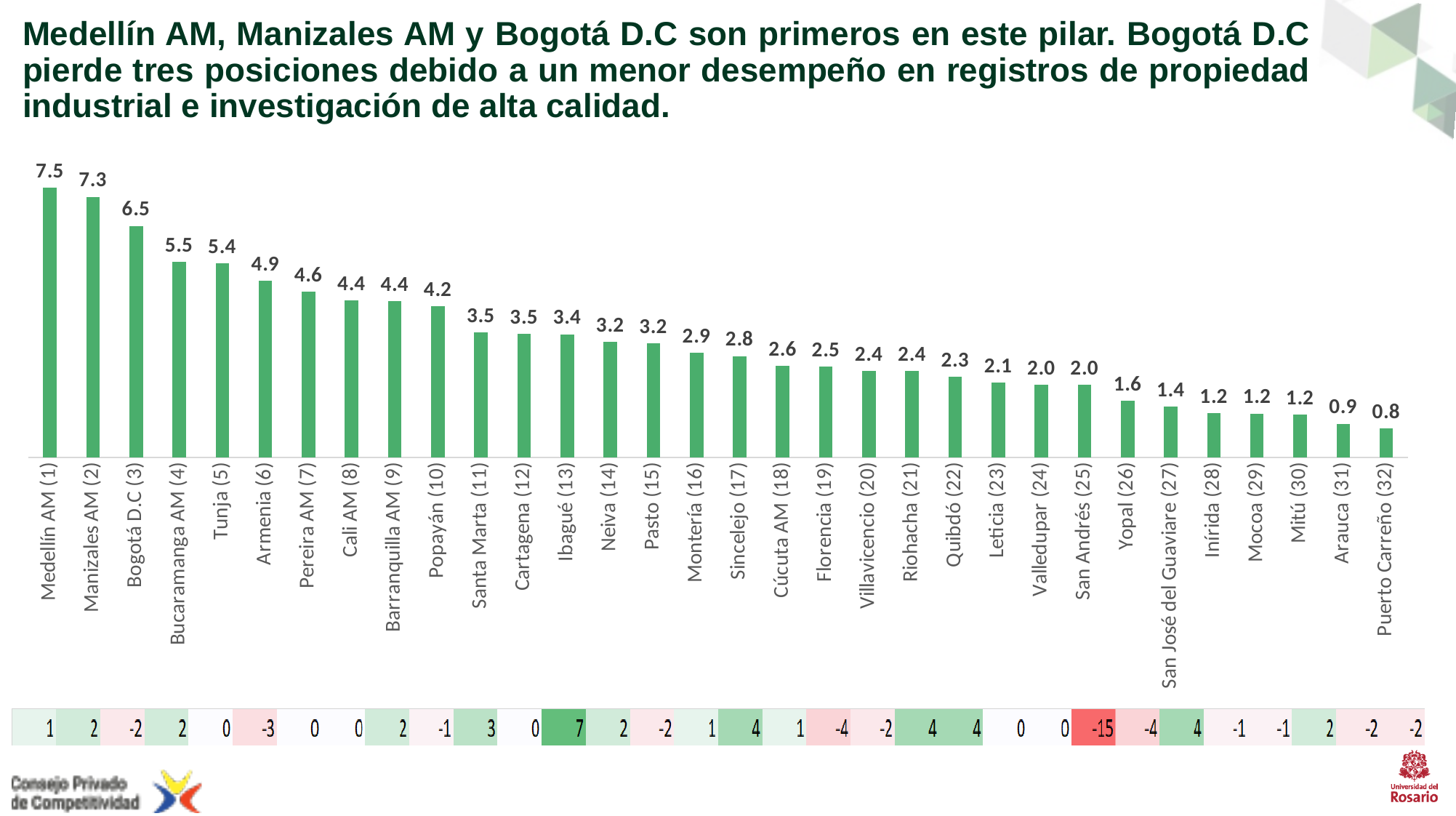
Which has a larger value, Tunja or Armenia? Tunja What is the difference between the values for Medellín AM and Bogotá D.C? 1.0 What is the value shown for Popayán? 4.2 How many cities or metropolitan areas are plotted in the chart? 32 Which city has the lowest value in the chart? Puerto Carreño Do the values rise or fall moving from left to right along the x axis? fall Which city has the highest value in the chart? Medellín AM What is the difference between the values for Bucaramanga AM and Santa Marta? 2.0 What kind of chart is shown on the slide? bar chart What is the value shown for Yopal? 1.6 What is the value shown for Bogotá D.C? 6.5 What is the value shown for Cúcuta AM? 2.6